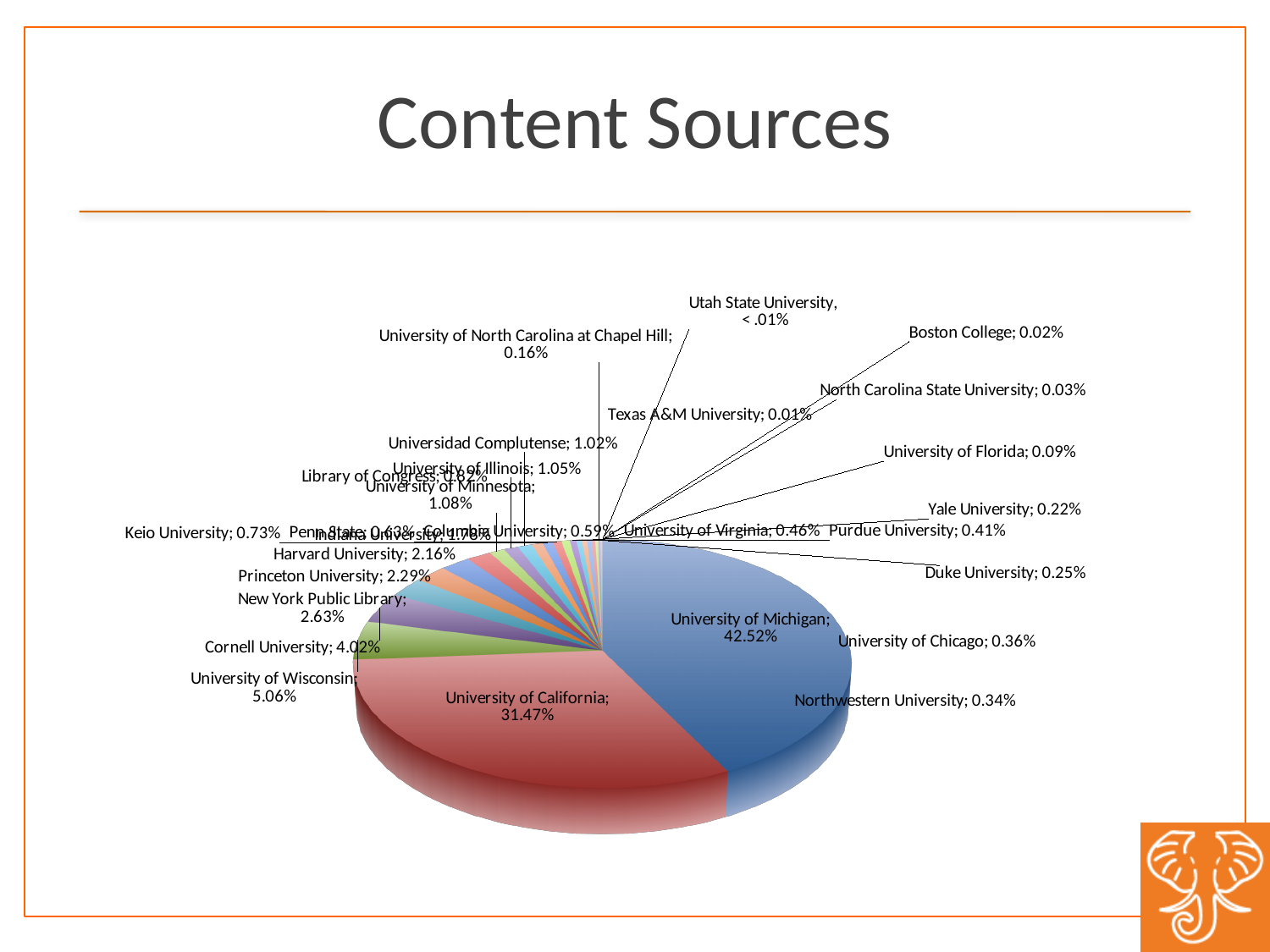
What percentage is shown for the New York Public Library? 2.63% Which content source has the smallest labelled share of the pie? Utah State University What percentage is shown for Yale University? 0.22% What percentage is shown for Cornell University? 4.02% What kind of chart is shown on the slide? pie chart What share of content sources does the University of Michigan account for? 42.52% What percentage is shown for the University of California? 31.47% What is the combined share of the University of Michigan and the University of California? 73.99% Which has the larger share, the University of Wisconsin or Cornell University? University of Wisconsin What is the title of the chart on the slide? Content Sources How many percentage points larger is the University of Michigan's share than the University of California's share? 11.05% Which content source has the largest share of the pie? University of Michigan